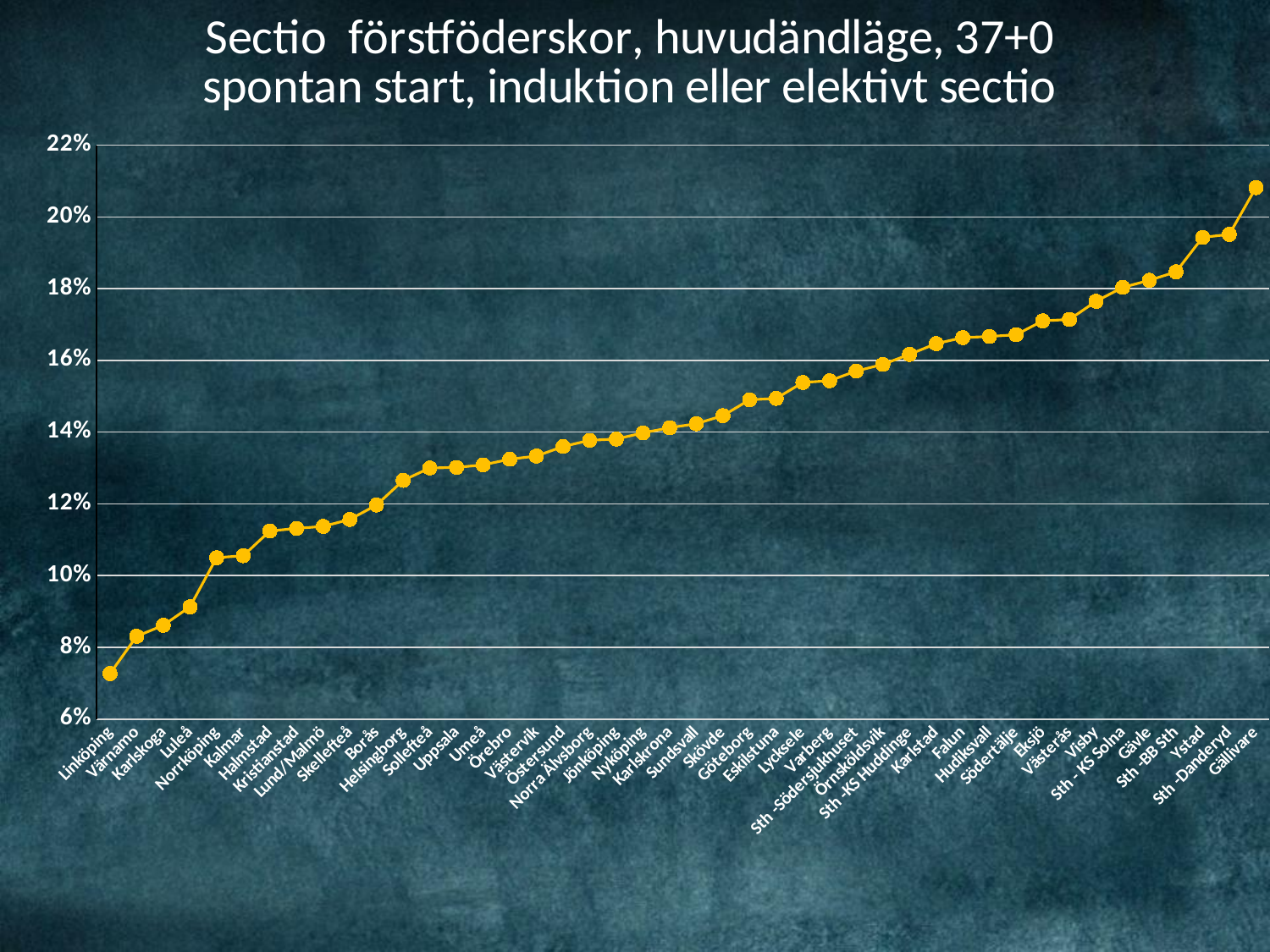
Which hospital has the highest value on the chart? Gällivare What kind of chart is shown on the slide? line chart Is the value for Norrköping greater or less than 10%? greater Do the values rise or fall from left to right along the x axis? rise Is the value for Linköping greater or less than 8%? less Is the value for Visby greater or less than 18%? less What is the highest value shown on the y axis? 22% Which has the larger value, Kalmar or Visby? Visby How many hospitals are plotted on the chart? 44 Which hospital has the lowest value on the chart? Linköping